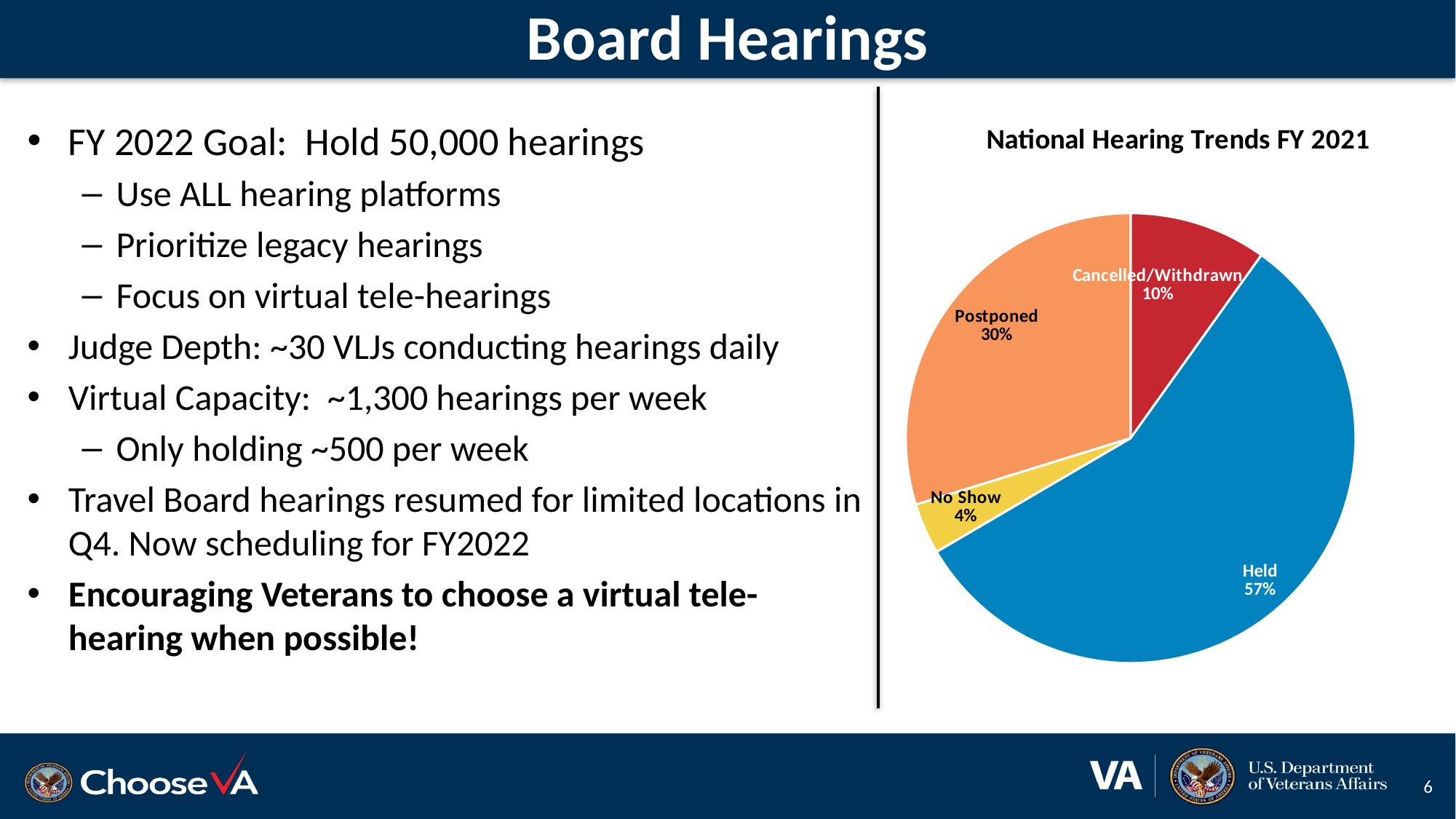
How many percentage points larger is the Held share than the Postponed share? 27 Which category has the smallest share of the pie chart? No Show How many categories are shown in the pie chart? 4 Which is larger, the Postponed share or the Cancelled/Withdrawn share? Postponed What colour is the Held slice of the pie chart? Blue What is the title of the chart? National Hearing Trends FY 2021 Which category has the largest share of the pie chart? Held What share of hearings were Held according to the pie chart? 57% What percentage of hearings were Postponed? 30% What percentage of hearings were Cancelled/Withdrawn? 10% What percentage of hearings were No Show? 4% What type of chart is shown on the slide? Pie chart